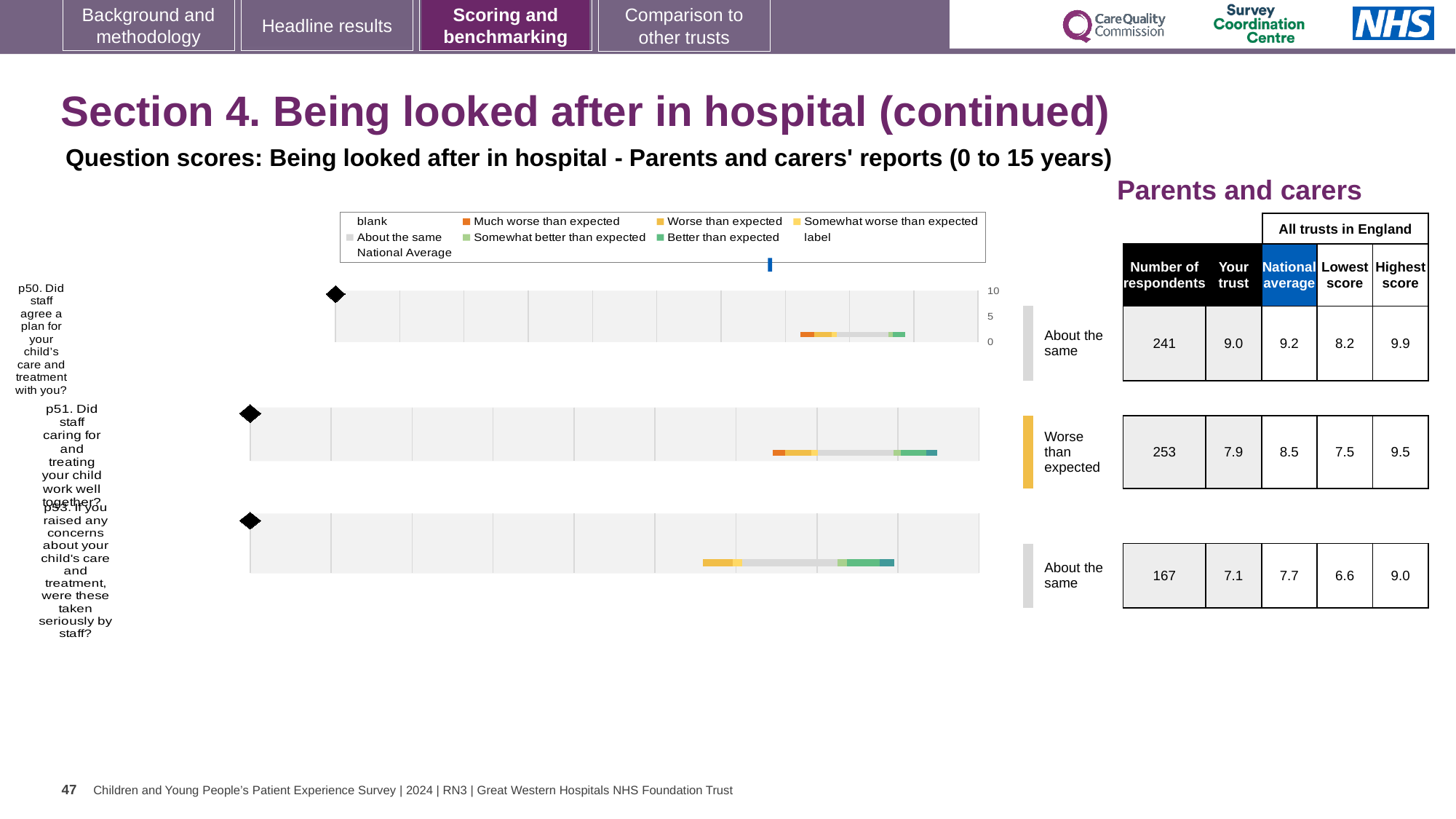
What is the highest score across all trusts in England for p50? 9.9 What is the 'Your trust' score for p50 (Did staff agree a plan for your child's care and treatment with you?)? 9.0 How many questions (chart rows) are plotted on the slide? 3 For p50, which is larger: the 'Your trust' score or the national average? National average Which question has the highest 'Your trust' score? p50 Which question has the lowest 'Your trust' score? p53 Which benchmark category is shown for p51 (Did staff caring for and treating your child work well together?)? Worse than expected How many respondents answered p53 (If you raised any concerns about your child's care and treatment, were these taken seriously by staff?)? 167 For p51, what is the difference between the national average and the 'Your trust' score? 0.6 What is the lowest score across all trusts in England for p53? 6.6 What is the national average score for p51 (Did staff caring for and treating your child work well together?)? 8.5 What kind of chart is used to show the question scores on this slide? bar chart